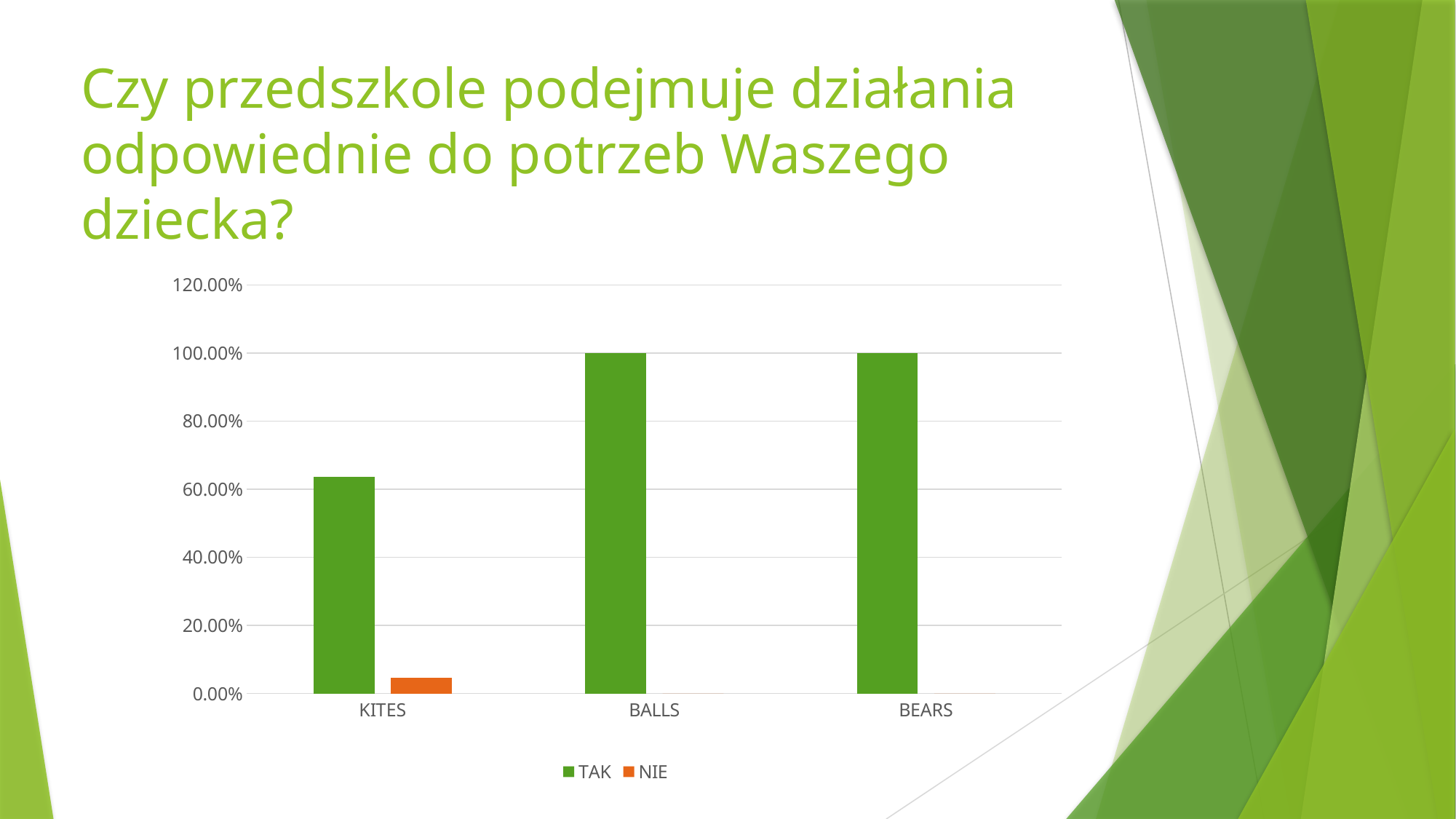
Is the NIE value for KITES greater or less than 20.00%? less Is the TAK value for KITES greater or less than 60.00%? greater How many series does the chart legend list? 2 What is the TAK value for BALLS? 100.00% Which category has the lowest TAK value? KITES What is the TAK value for BEARS? 100.00% What are the two series named in the chart legend? TAK and NIE What type of chart is shown on the slide? bar chart Which is larger for KITES, the TAK value or the NIE value? TAK Which colour represents the NIE series in the chart? orange Is the TAK value for KITES greater or less than 80.00%? less How many categories are shown on the x axis of the chart? 3